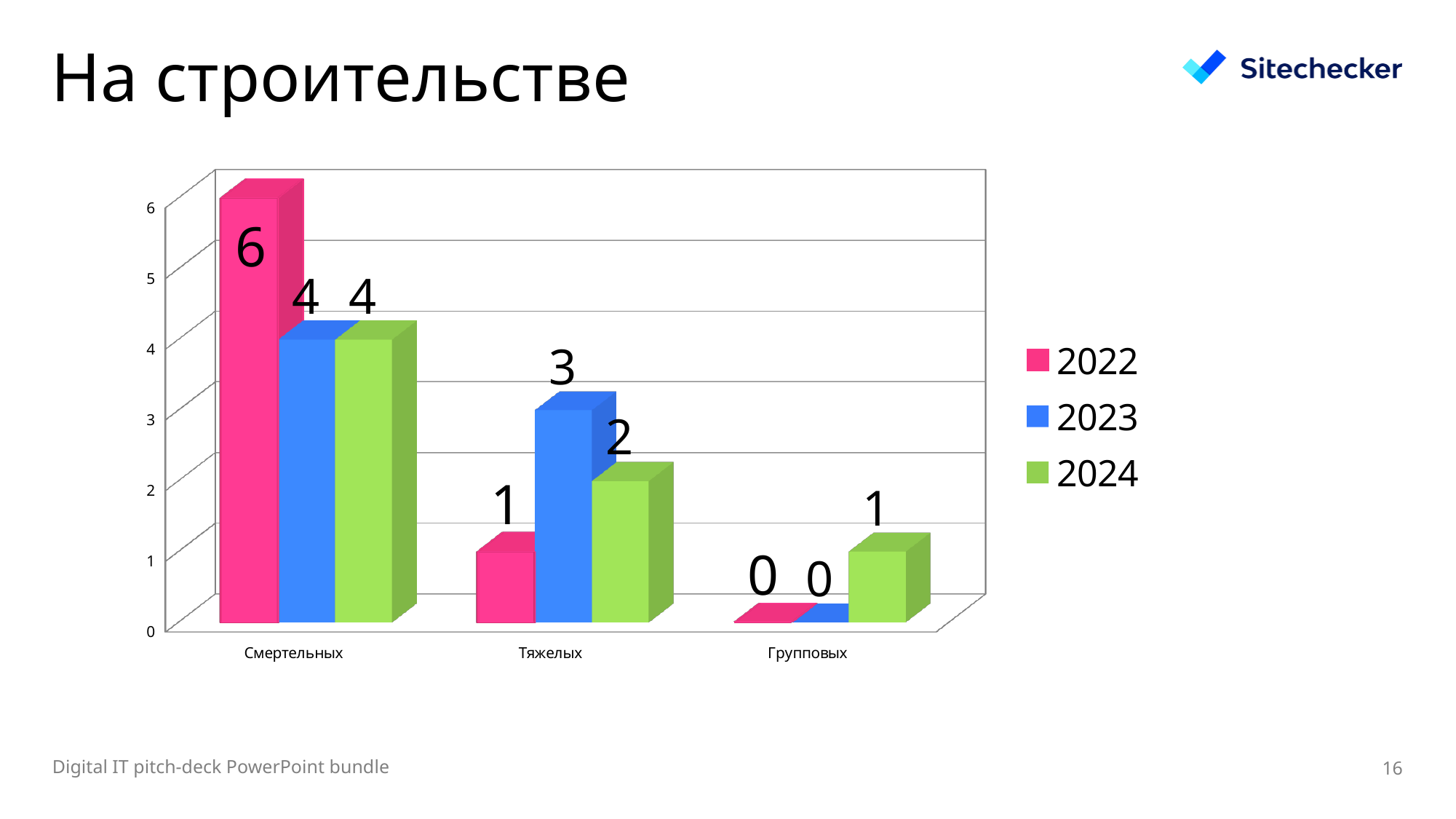
What is the value for 2022 in the Групповых category? 0 Which category has the lowest value for the 2024 series? Групповых Which colour represents the 2024 series in the legend? Green Which category has the highest value for the 2022 series? Смертельных How many series does the legend list? 3 What is the value for 2024 in the Групповых category? 1 What is the value for 2023 in the Тяжелых category? 3 Which is larger in the Тяжелых category: the 2023 value or the 2024 value? 2023 What kind of chart is shown on the slide? Bar chart What is the difference between the 2022 and 2023 values in the Смертельных category? 2 What is the value for 2022 in the Смертельных category? 6 How many categories are shown on the x axis? 3